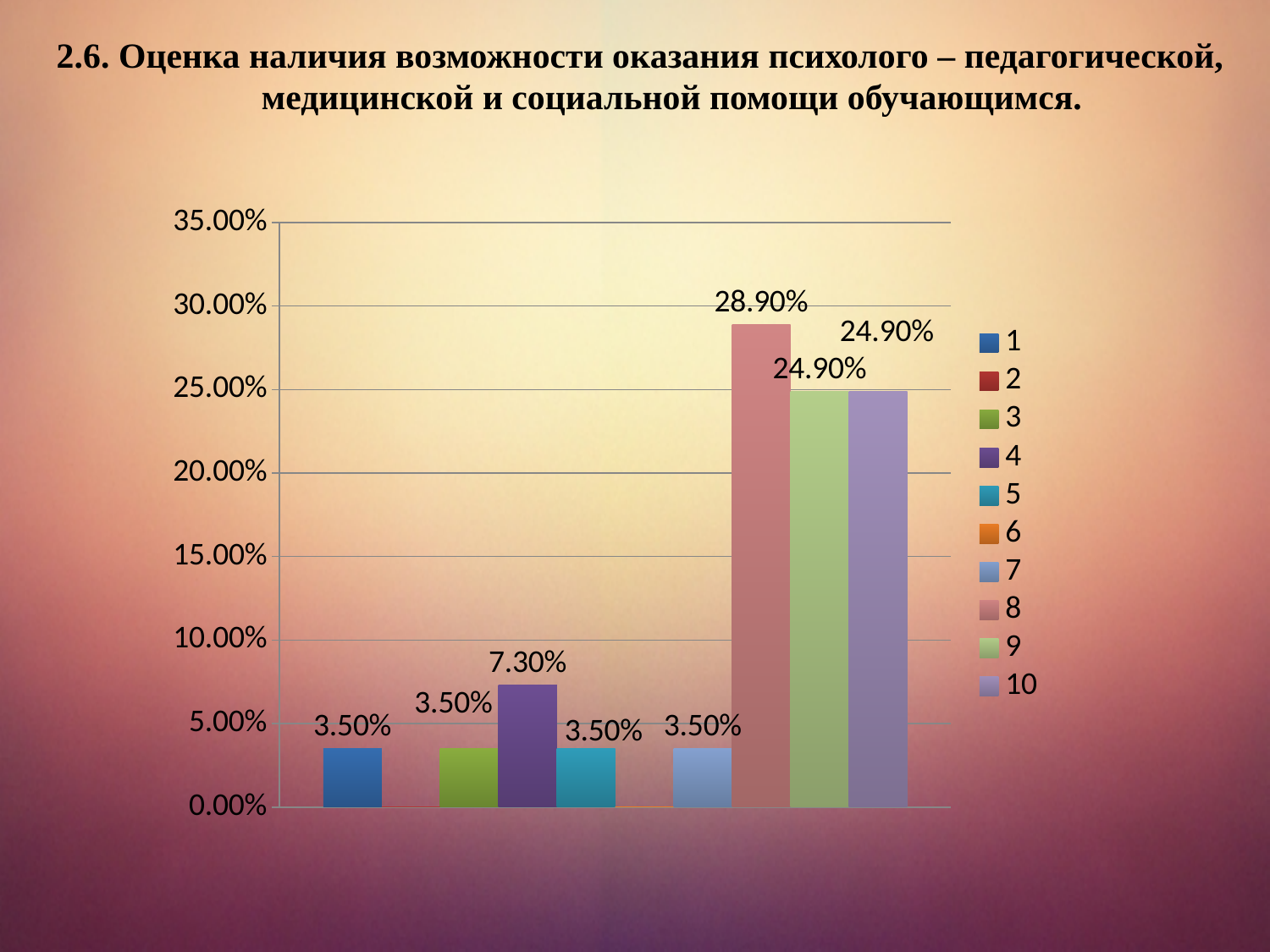
How many series does the legend list? 10 Is the value for series 8 greater or less than 25.00%? greater What is the value for series 4? 7.30% Which is larger, the value for series 4 or the value for series 7? series 4 What kind of chart is shown on the slide? bar chart What is the value for series 1? 3.50% What is the difference between the values for series 8 and series 9? 4.00% Which series has the highest value? 8 What colour is the bar for series 8? pink What is the value for series 8? 28.90% What is the value for series 9? 24.90% What is the difference between the values for series 4 and series 5? 3.80%